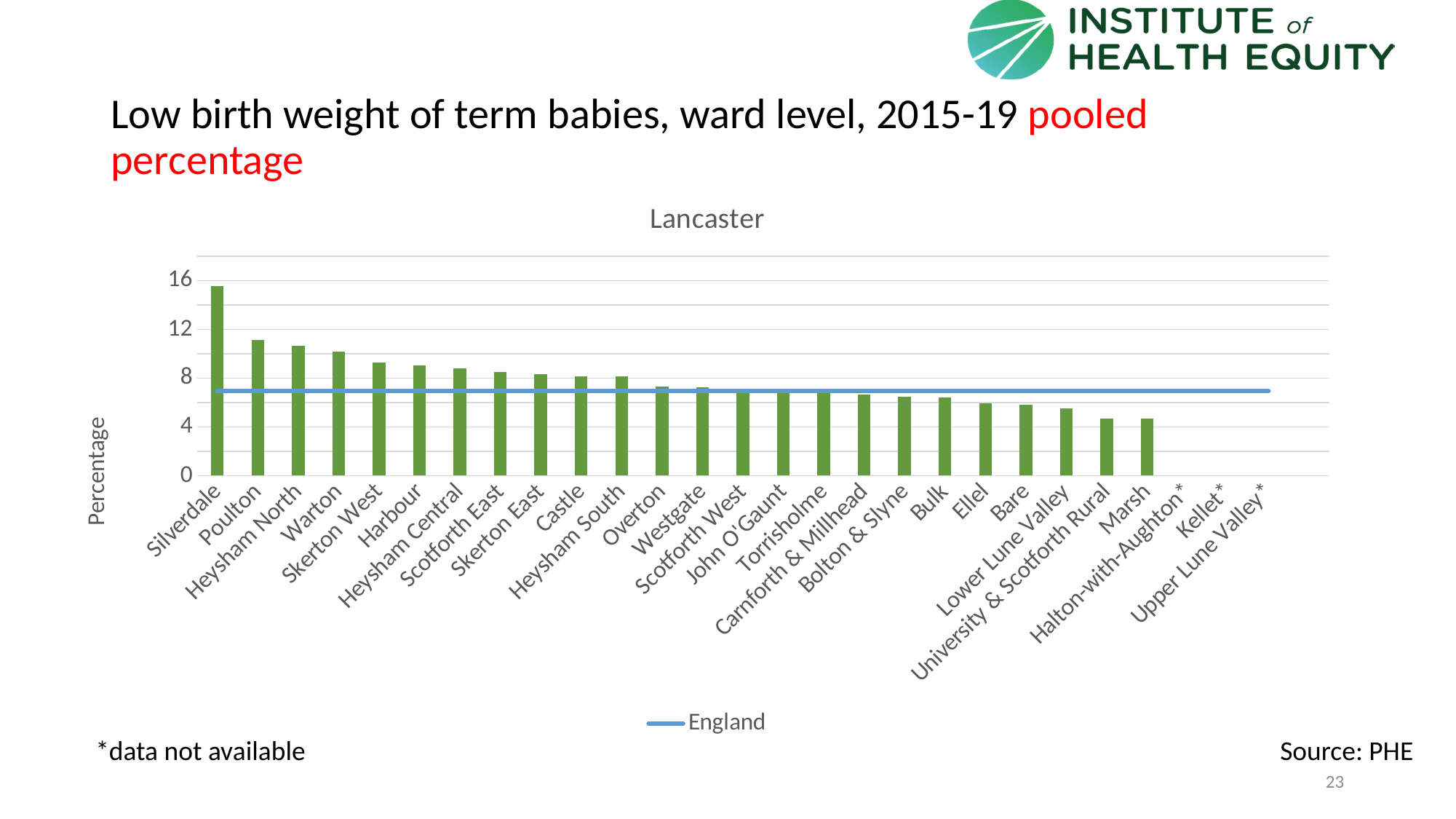
Is the value for Marsh greater or less than 8? less Which is larger, the value for Warton or the value for Bare? Warton What is the title of the chart? Lancaster Is the value for Poulton greater or less than 8? greater Is the value for Silverdale greater or less than 12? greater What kind of chart is shown on the slide? Combination bar and line chart How many series does the legend list? 1 Do the bar values rise or fall moving from left to right along the x axis? Fall How many wards have a bar plotted in the chart? 24 Which is larger, the value for Silverdale or the value for Poulton? Silverdale Which ward has the highest low birth weight percentage in the chart? Silverdale